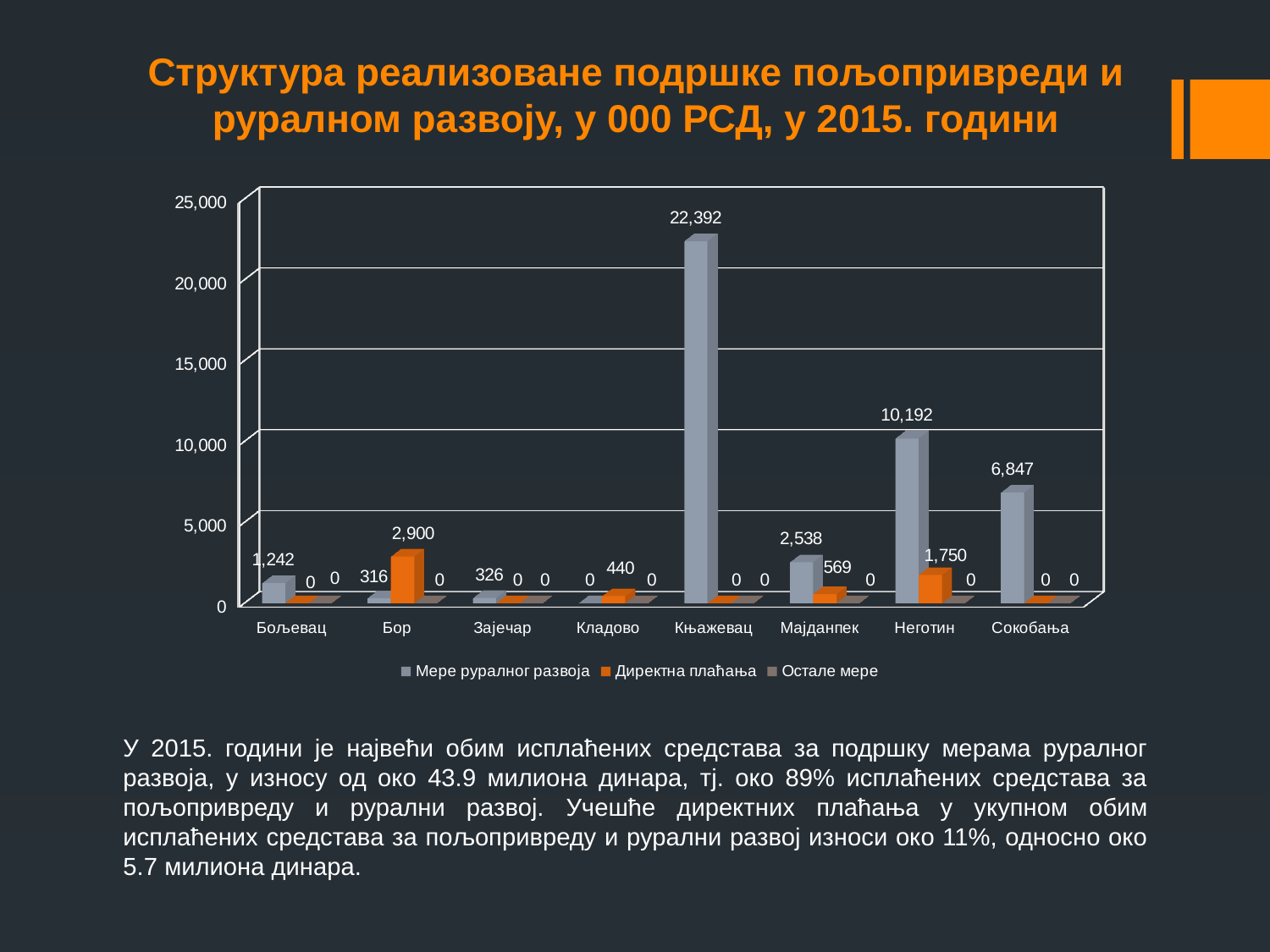
Which category has the highest value for Директна плаћања? Бор What kind of chart is shown on the slide? Bar chart Which is larger: Мере руралног развоја for Бољевац or Мере руралног развоја for Мајданпек? Мајданпек What is the difference between the Мере руралног развоја values for Неготин and Сокобања? 3,345 How many categories are shown on the x axis? 8 Which category has the highest value for Мере руралног развоја? Књажевац What is the value of Директна плаћања for Кладово? 440 What is the value of Мере руралног развоја for Књажевац? 22,392 What is the value of Директна плаћања for Мајданпек? 569 How many series does the legend list? 3 What is the value of Директна плаћања for Бор? 2,900 What is the value of Мере руралног развоја for Неготин? 10,192